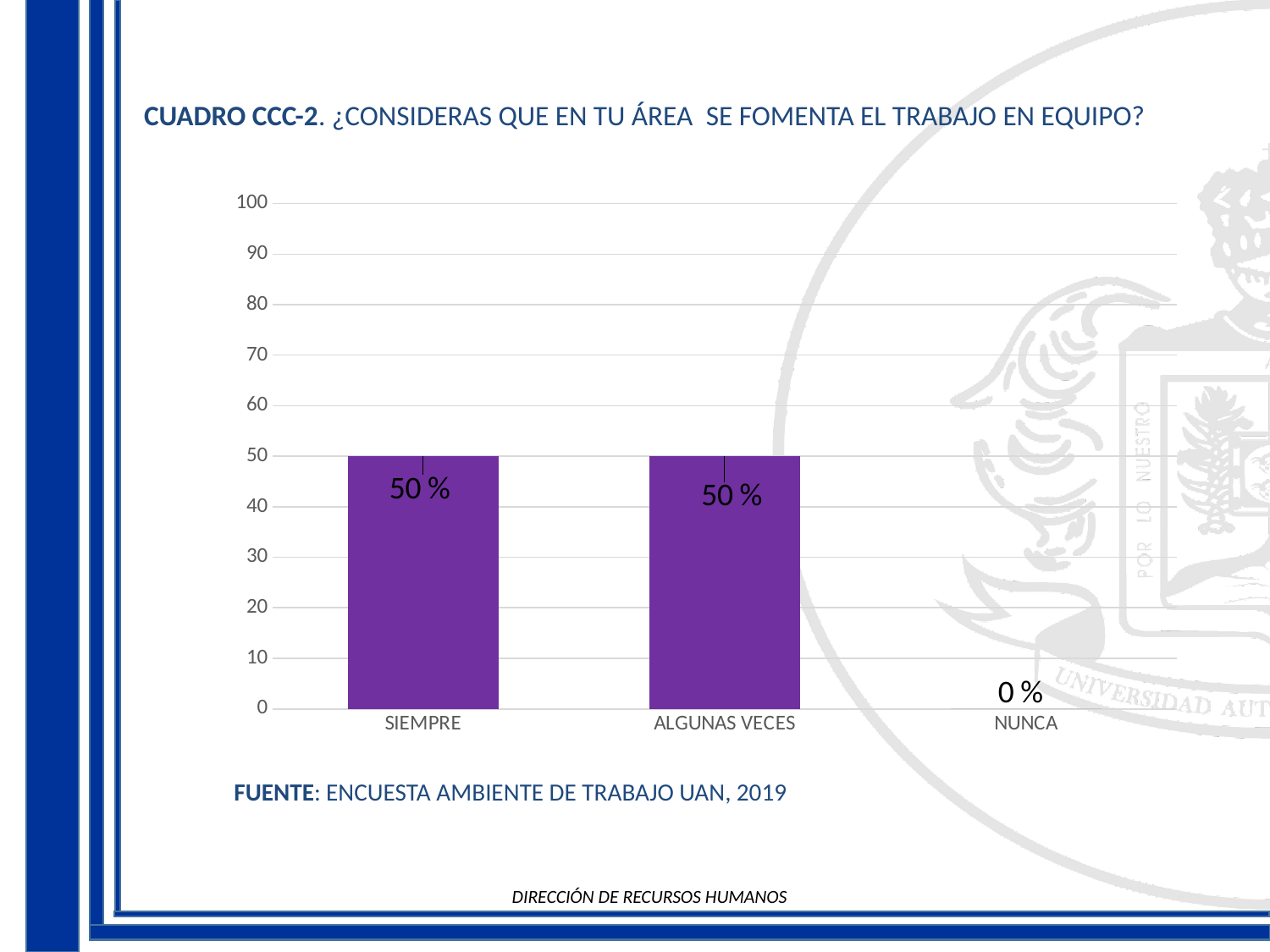
How many categories are shown on the x axis? 3 What is the value for ALGUNAS VECES? 50 % What kind of chart is shown on the slide? bar chart What is the highest value shown on the vertical axis? 100 What is the value for NUNCA? 0 % Is the value for ALGUNAS VECES greater or less than 40? greater Which is larger, the value for ALGUNAS VECES or the value for NUNCA? ALGUNAS VECES What is the value for SIEMPRE? 50 % What is the difference between the values for SIEMPRE and NUNCA? 50 % Which category has the lowest value? NUNCA What source is cited below the chart? ENCUESTA AMBIENTE DE TRABAJO UAN, 2019 Is the value for SIEMPRE greater or less than 60? less